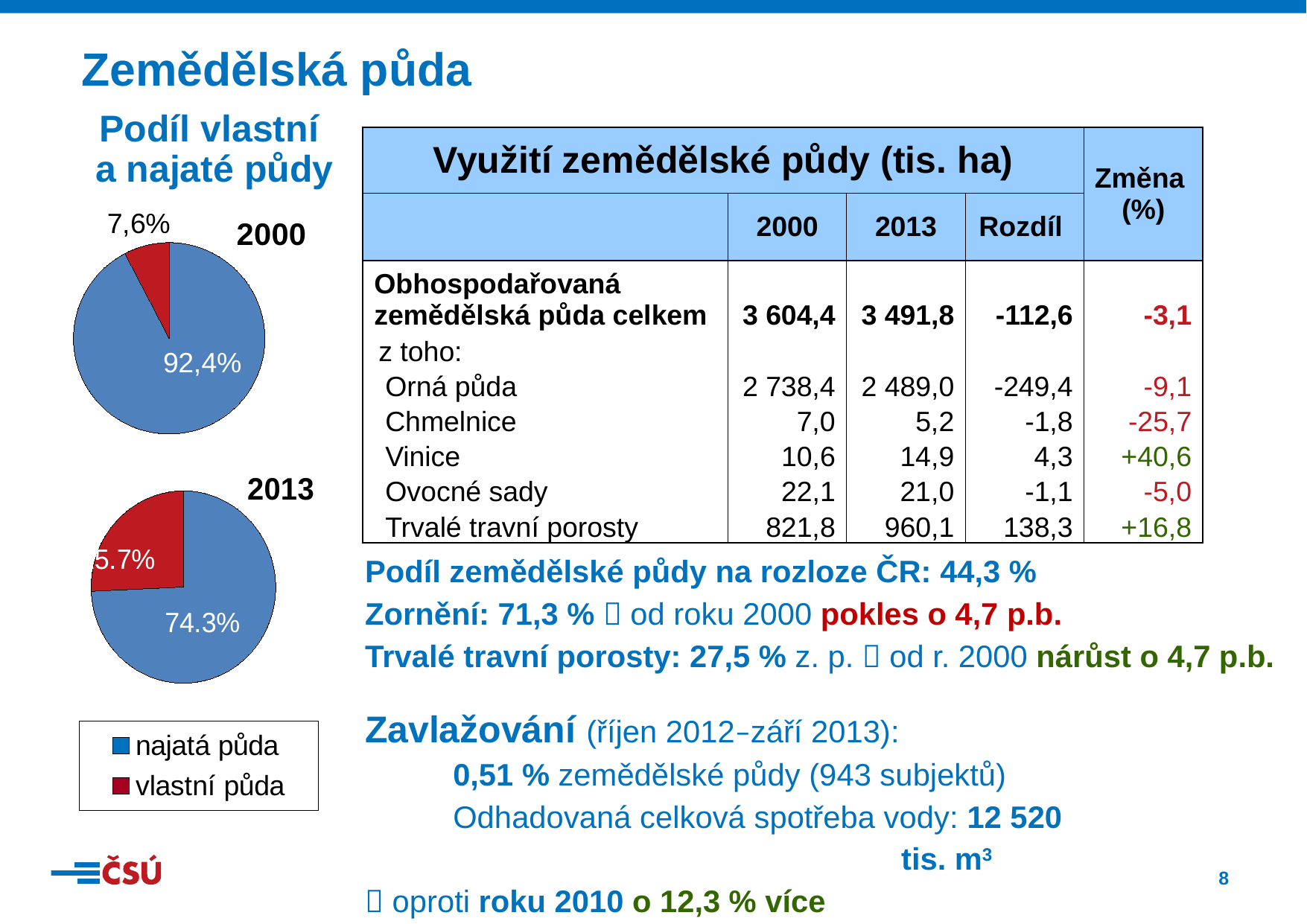
How many slices does the 2000 pie chart have? 2 In the 2000 pie chart, what share is labelled for najatá půda? 92,4% In the 2000 pie chart, what share is labelled for vlastní půda? 7,6% What kind of chart is used to show the share of own and rented land for 2000 and 2013? pie chart In the 2000 pie chart, which category has the largest slice? najatá půda In the 2013 pie chart, is the share of vlastní půda greater or less than 50%? less Did the share of najatá půda rise or fall from the 2000 pie chart to the 2013 pie chart? fall In the 2013 pie chart, which slice is larger, najatá půda or vlastní půda? najatá půda What colour represents najatá půda in the pie charts? blue In the 2000 pie chart, what is the difference in percentage points between the najatá půda slice and the vlastní půda slice? 84,8 In the 2013 pie chart, what share is labelled for najatá půda? 74.3% How many entries does the legend of the pie charts list? 2